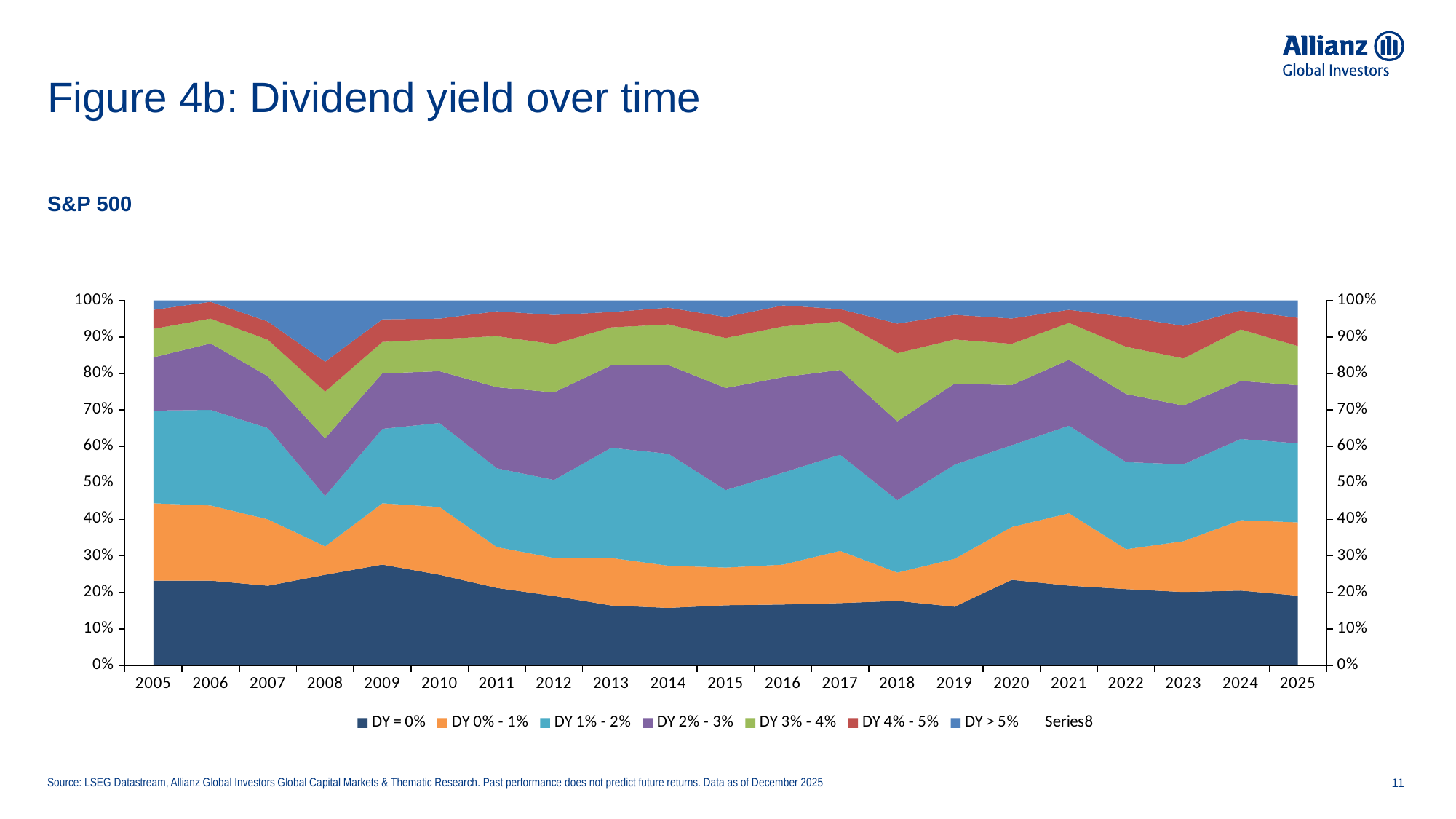
Does the DY = 0% share rise or fall from 2009 to 2014? fall In which year is the DY > 5% share the largest? 2008 Is the value for DY = 0% in 2009 greater or less than 20%? greater Is the value for DY = 0% in 2020 greater or less than 20%? greater What kind of chart is shown on the slide? Stacked area chart Is the value for DY = 0% in 2014 greater or less than 20%? less How many years are plotted along the x axis? 21 How many series does the legend list? 8 What is the title of the figure on the slide? Figure 4b: Dividend yield over time Which index does the chart cover, according to the label above it? S&P 500 In which year is the DY = 0% share the highest? 2009